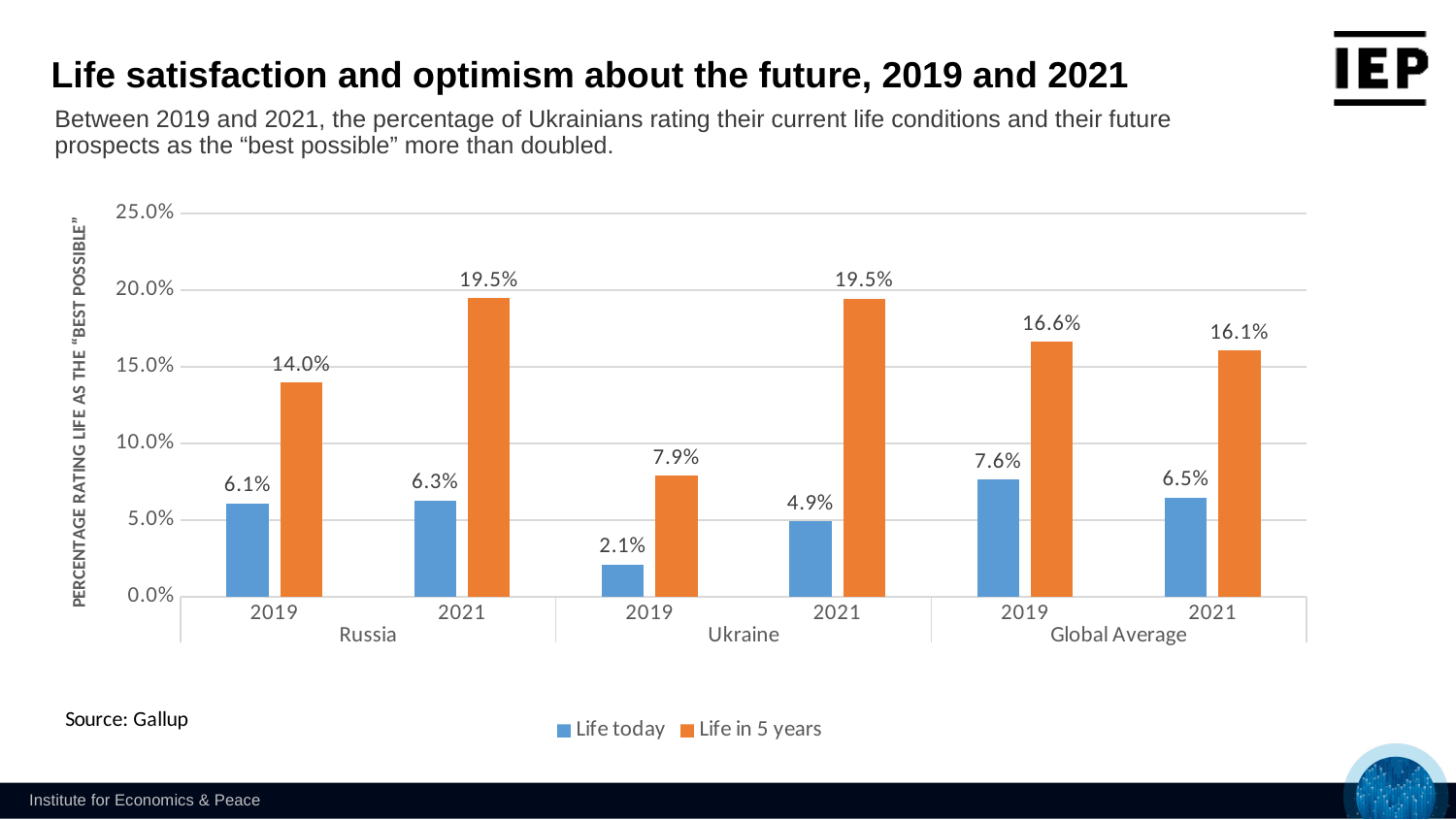
Which is larger: the "Life in 5 years" value for Russia in 2019 or for the Global Average in 2019? Global Average in 2019 What is the value for "Life today" for the Global Average in 2021? 6.5% What is the value for "Life in 5 years" in Russia in 2021? 19.5% Which group and year has the highest "Life today" value? Global Average, 2019 Did the "Life today" value for Ukraine rise or fall from 2019 to 2021? Rise What is the source cited for the chart? Gallup What is the value for "Life today" in Ukraine in 2019? 2.1% How many country/region groups are shown on the x axis? 3 Which group and year has the lowest "Life today" value? Ukraine, 2019 How many series does the legend list? 2 What kind of chart is shown on the slide? Bar chart What is the difference between the "Life in 5 years" values for Ukraine in 2021 and 2019? 11.6%